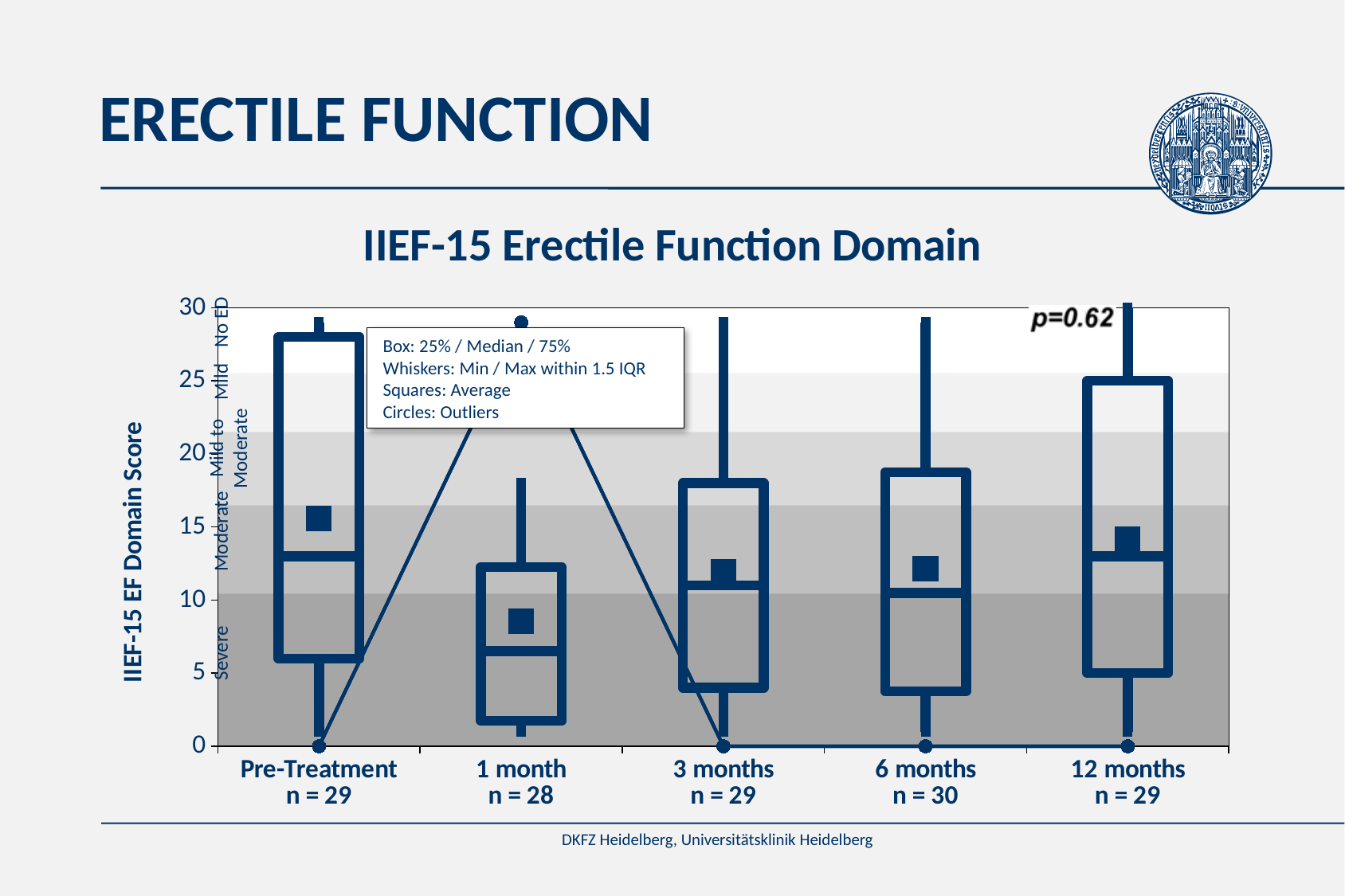
What is the title of the chart? IIEF-15 Erectile Function Domain Which time point has the smallest sample size? 1 month Which time point has the lowest median IIEF-15 EF Domain Score? 1 month Which time point has the largest sample size? 6 months What p-value is printed on the chart? p=0.62 What is the sample size (n) at 6 months? n = 30 Is the median IIEF-15 EF Domain Score at Pre-Treatment greater or less than 15? less Is the median IIEF-15 EF Domain Score at 1 month greater or less than 10? less How many time points are shown on the x axis of the chart? 5 What kind of chart is shown on the slide? Box plot What is the sample size (n) at 1 month? n = 28 According to the chart's legend box, what do the squares represent? Average